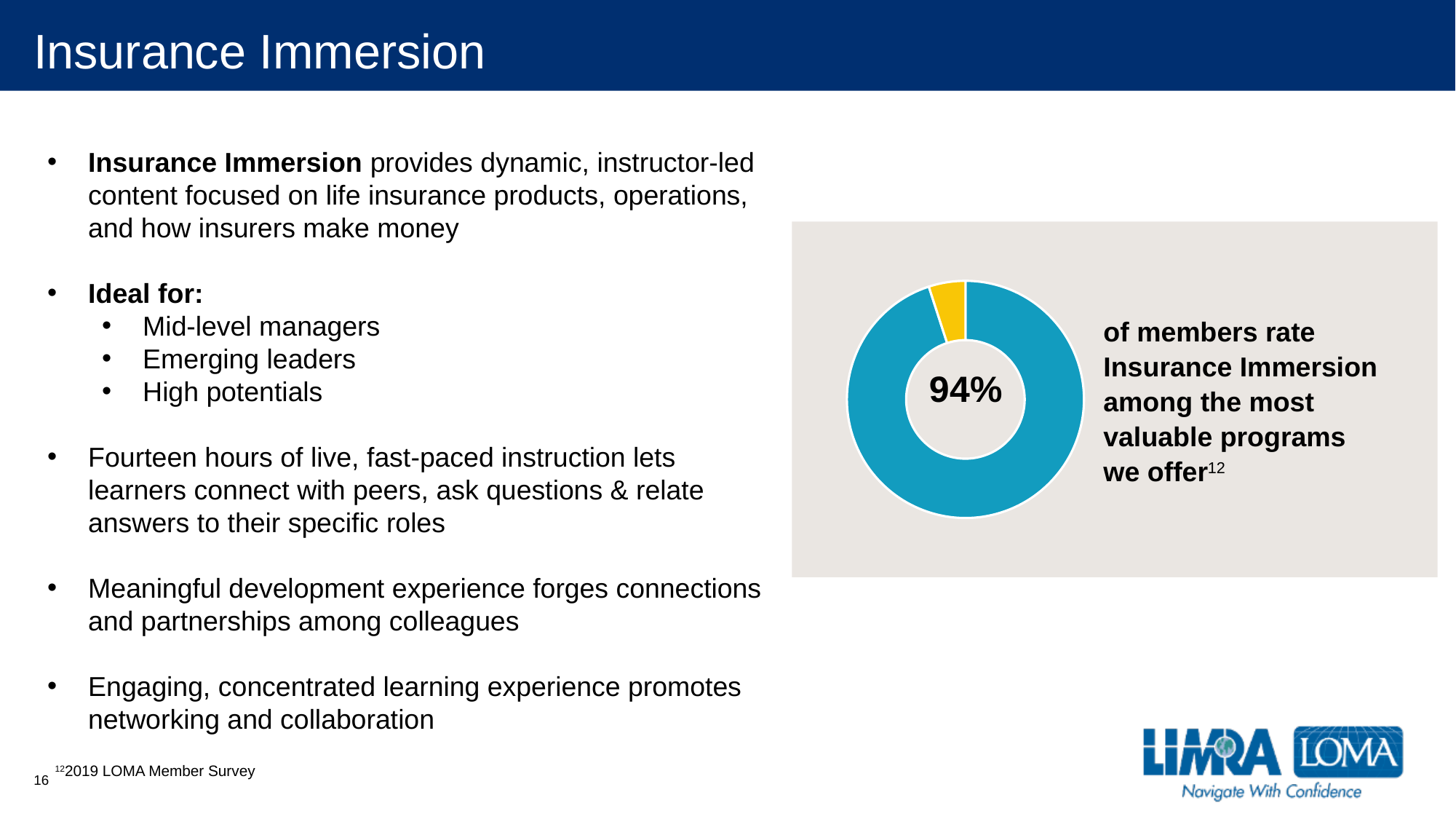
What kind of chart is shown on the right side of the slide? Donut (pie) chart What percentage is printed in the center of the donut chart? 94% Is the share represented by the blue slice of the donut chart greater or less than 50%? greater According to the donut chart, what share of members rate Insurance Immersion among the most valuable programs offered? 94% How many slices does the donut chart have? 2 What survey is cited as the source for the donut chart's statistic? 2019 LOMA Member Survey Which slice of the donut chart is larger, the blue one or the yellow one? The blue one Is the share represented by the yellow slice of the donut chart greater or less than 25%? less What colour is the large slice of the donut chart? Blue Which slice of the donut chart is the smallest? The yellow slice